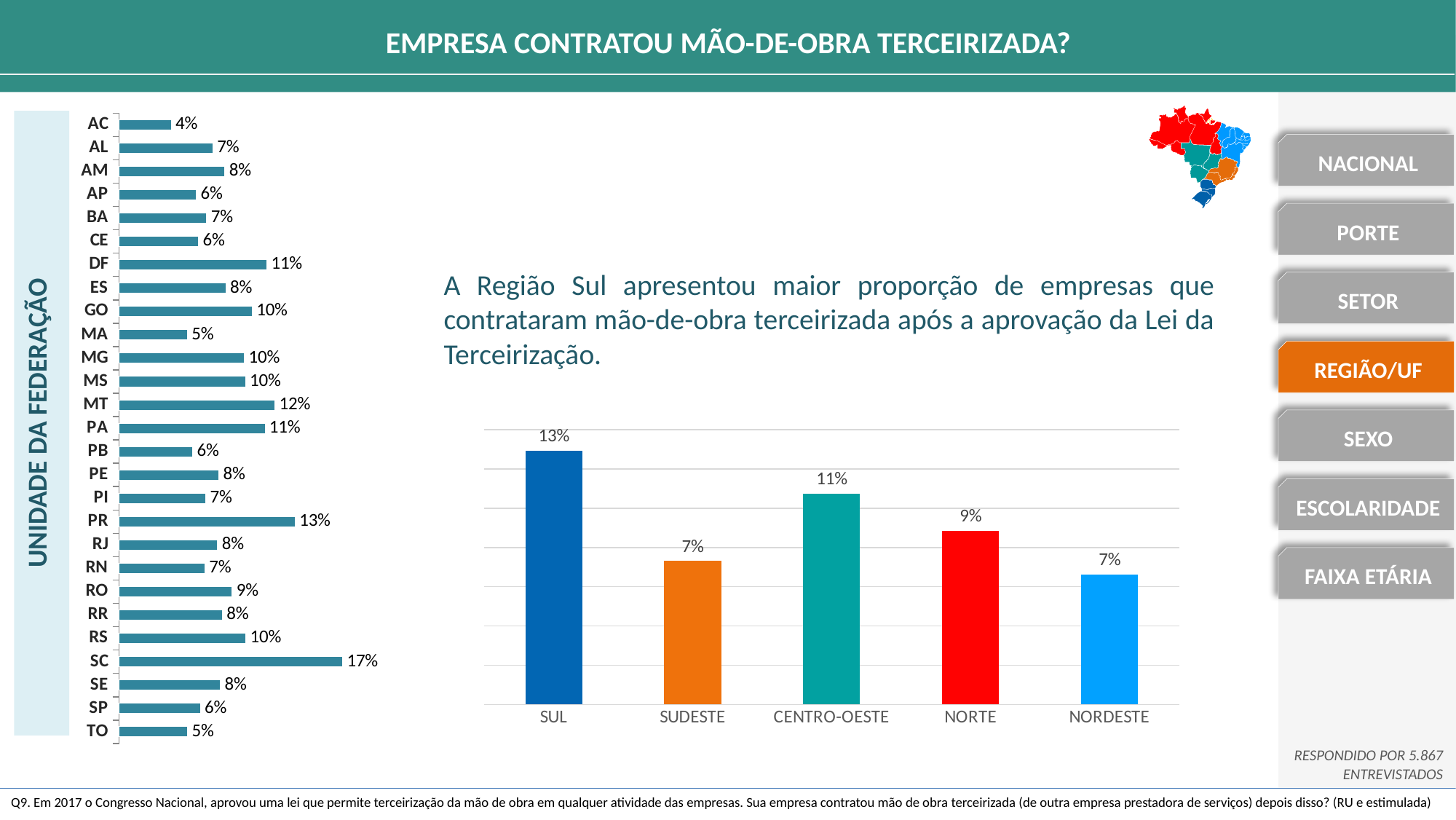
In the region bar chart on the right, how many regions are shown? 5 In the region bar chart on the right, which is larger, CENTRO-OESTE or NORTE? CENTRO-OESTE In the region bar chart on the right, what is the value for SUL? 13% In the state bar chart on the left (Unidade da Federação), what is the value for SC? 17% In the state bar chart on the left (Unidade da Federação), what is the difference between SC and PR? 4% In the state bar chart on the left (Unidade da Federação), which state has the lowest value? AC In the state bar chart on the left (Unidade da Federação), how many states are listed? 27 In the state bar chart on the left (Unidade da Federação), what is the value for MT? 12% In the region bar chart on the right, which region has the highest value? SUL In the region bar chart on the right, what is the difference between SUL and NORTE? 4% In the region bar chart on the right, what kind of chart is it? Bar chart In the region bar chart on the right, what is the value for CENTRO-OESTE? 11%